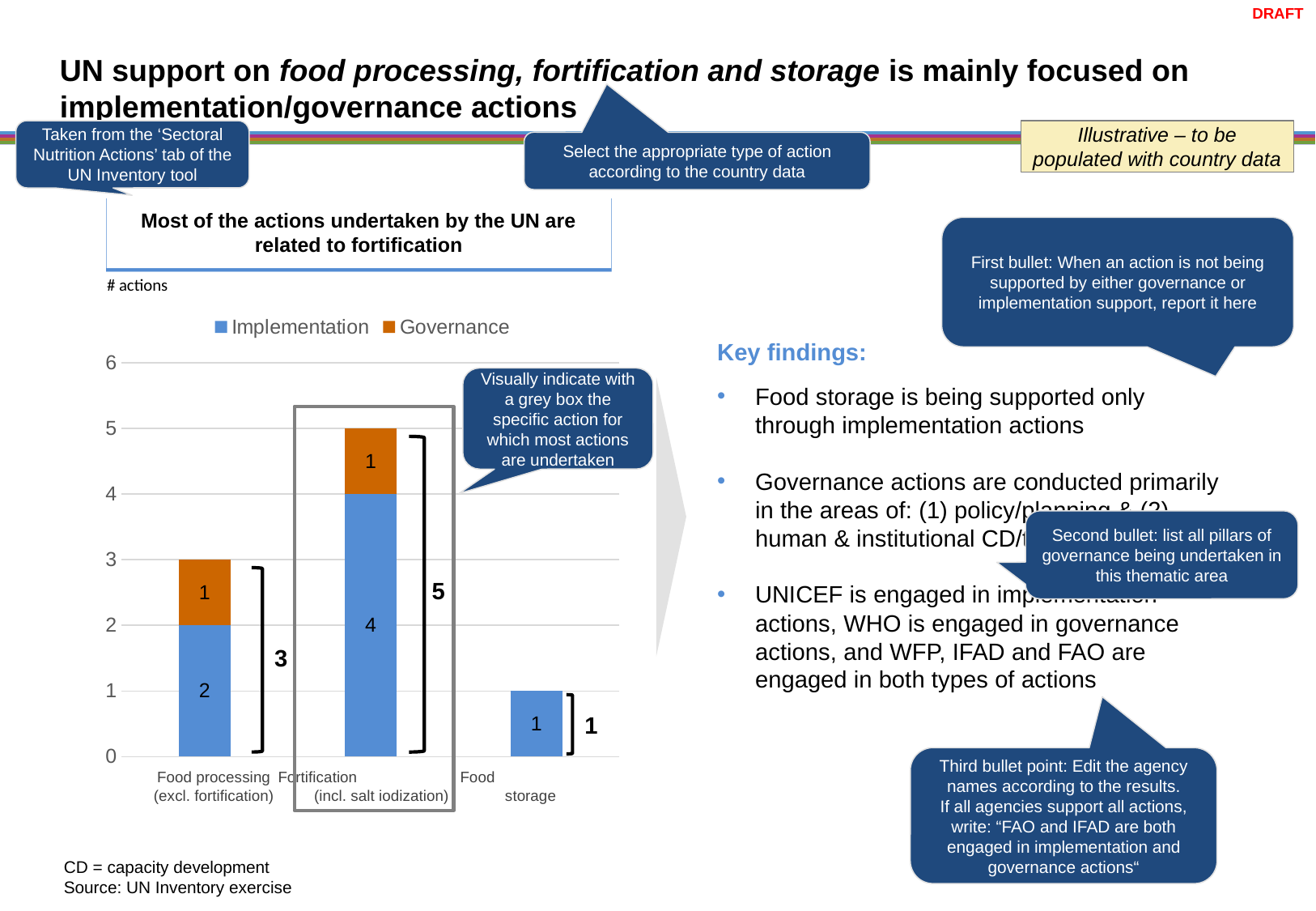
What is the Governance value for Food processing (excl. fortification)? 1 What is the Implementation value for Food storage? 1 How many series does the chart legend list? 2 What type of chart is shown on the slide? Stacked bar chart Which category has the highest total number of actions? Fortification (incl. salt iodization) What is the total number of actions for the Food processing (excl. fortification) bar? 3 Which category has the lowest total number of actions? Food storage What is the Implementation value for Fortification (incl. salt iodization)? 4 How many categories are shown on the x axis of the chart? 3 What is the difference between the Implementation values for Fortification (incl. salt iodization) and Food processing (excl. fortification)? 2 What is the total number of actions for the Fortification (incl. salt iodization) bar? 5 Which is larger: the total for Food processing (excl. fortification) or the total for Food storage? Food processing (excl. fortification)